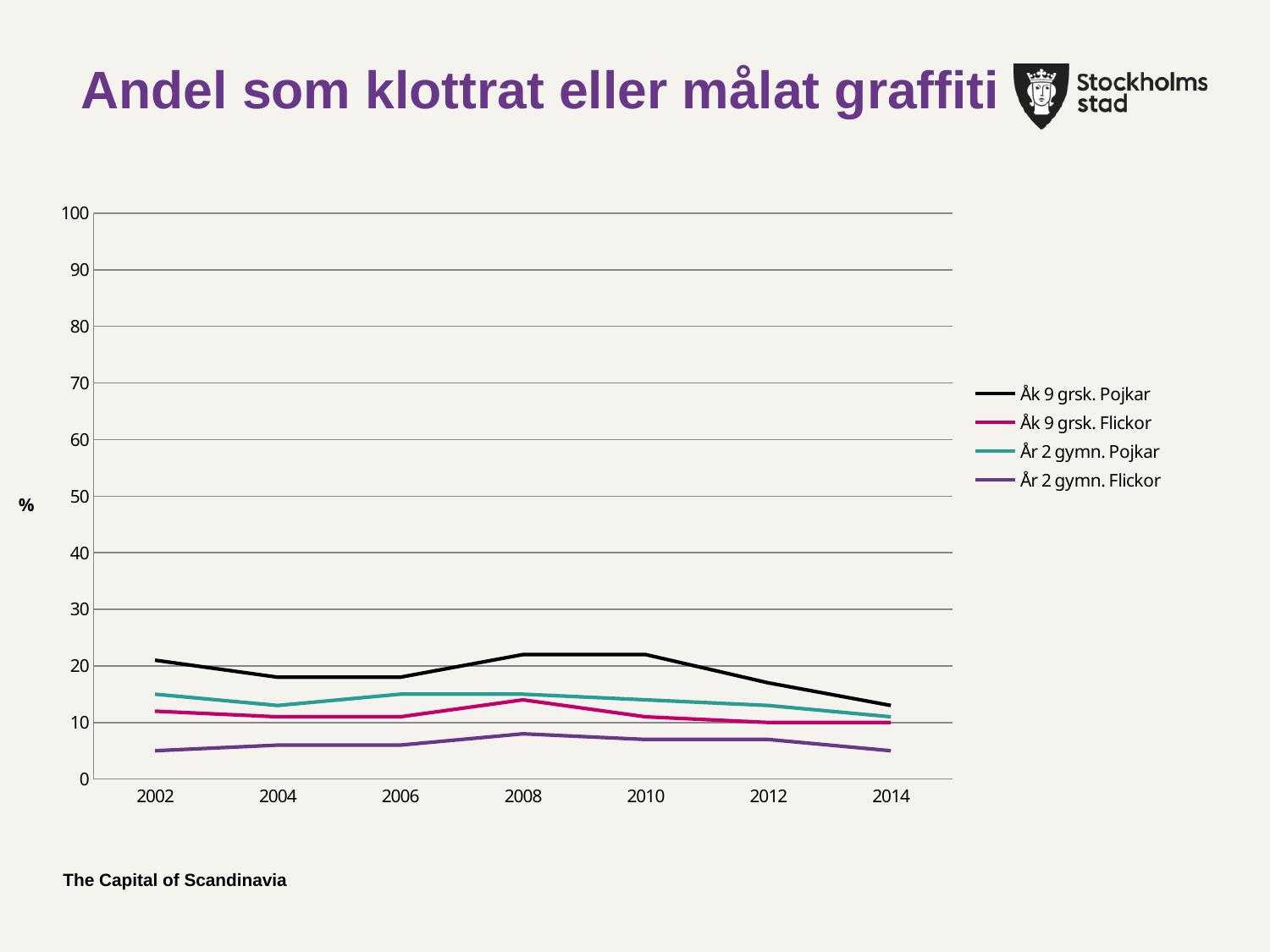
Is the value for År 2 gymn. Flickor in 2002 greater or less than 10? less Which series has the lowest values across the whole period? År 2 gymn. Flickor Is the value for Åk 9 grsk. Pojkar in 2014 greater or less than 10? greater How many series does the legend list? 4 Is the value for Åk 9 grsk. Flickor in 2008 greater or less than 10? greater What is the title of the chart on the slide? Andel som klottrat eller målat graffiti What kind of chart is shown on the slide? line chart Which series has the highest values across the whole period? Åk 9 grsk. Pojkar How many years are shown on the x axis? 7 Does the value for Åk 9 grsk. Pojkar rise or fall from 2010 to 2014? fall In 2014, which is larger: Åk 9 grsk. Pojkar or År 2 gymn. Flickor? Åk 9 grsk. Pojkar